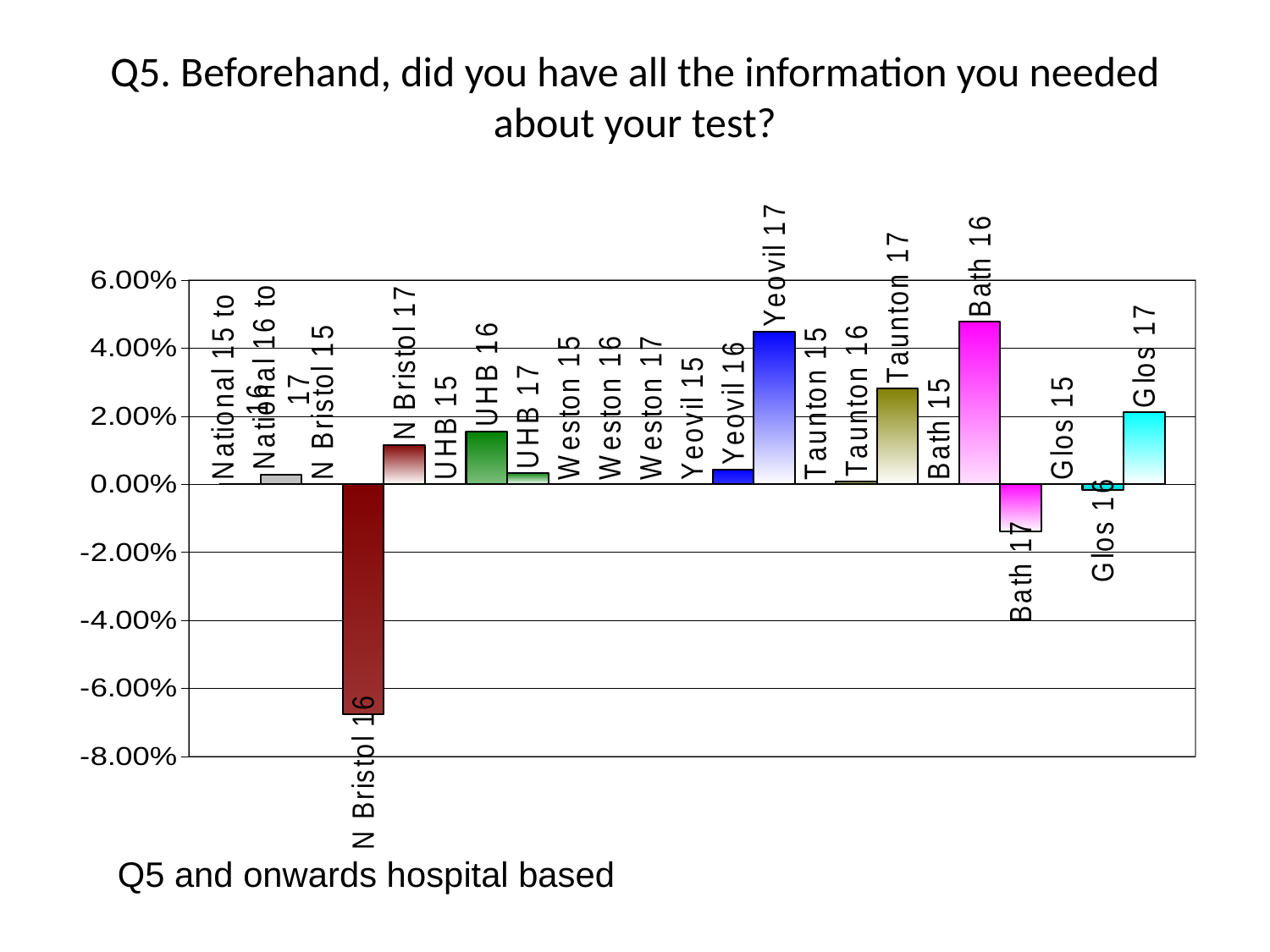
How many categories are shown on the x axis of the chart? 23 Which category has the highest value? Bath 16 Which category has the lowest value? N Bristol 16 What is the title of the chart? Q5. Beforehand, did you have all the information you needed about your test? What kind of chart is shown on the slide? bar chart Is the value for Yeovil 17 greater or less than 4.00%? greater Is the value for Bath 16 greater or less than 4.00%? greater Is the value for Bath 17 greater or less than -1.00%? less Which is larger, the value for Taunton 17 or the value for UHB 16? Taunton 17 Which is larger, the value for N Bristol 17 or the value for UHB 17? N Bristol 17